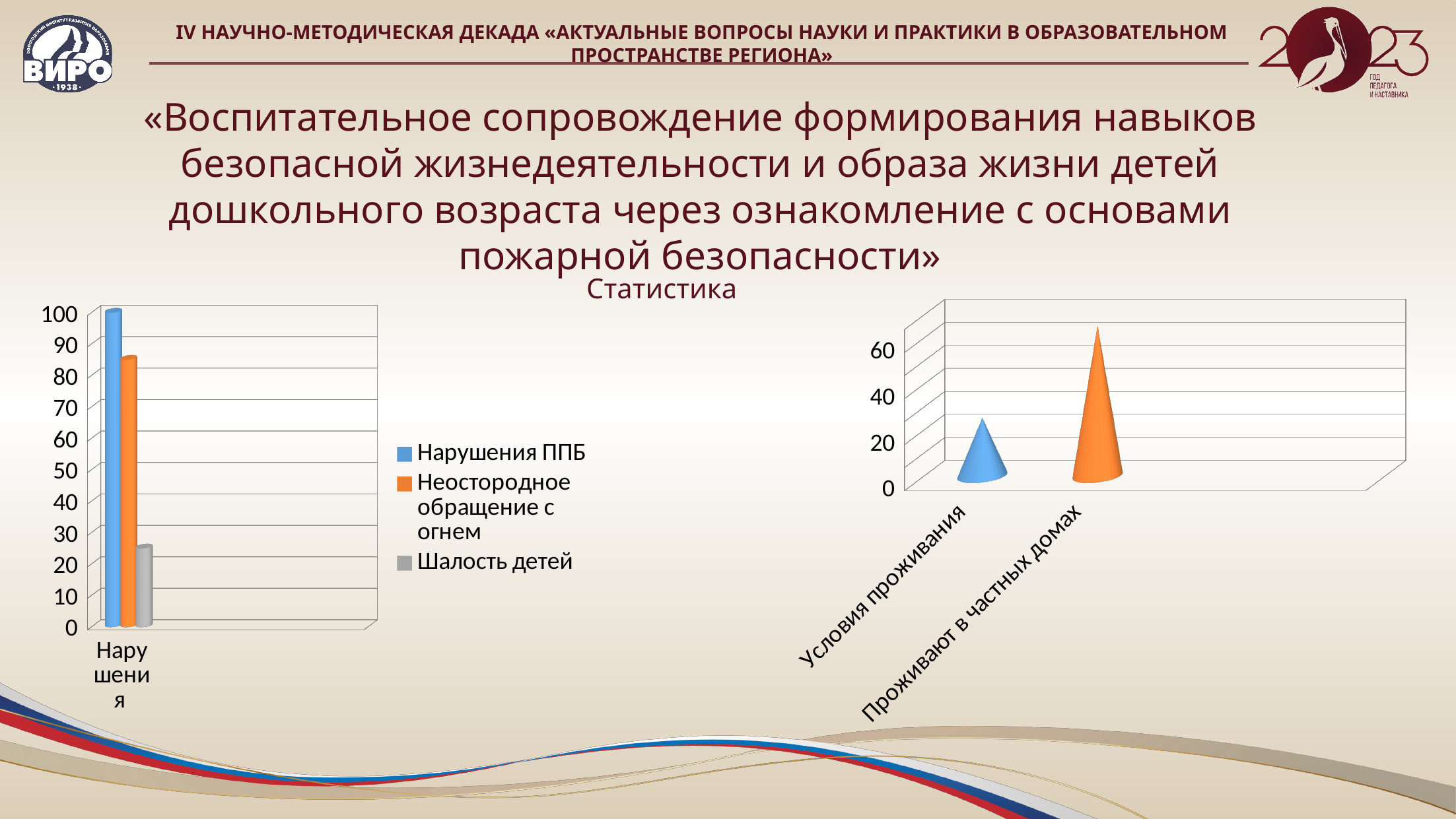
How many categories are shown on the x axis of the right chart? 2 In the left chart, which series has the highest value? Нарушения ППБ In the left chart, is the value for Шалость детей greater or less than 30? less How many series does the legend of the left chart list? 3 What kind of chart is the left chart on the slide? bar chart In the right chart, is the value for Условия проживания greater or less than 40? less In the right chart, which category has the higher value? Проживают в частных домах In the left chart, is the value for Неосторожное обращение с огнем greater or less than 80? greater In the left chart, which is larger: Неосторожное обращение с огнем or Шалость детей? Неосторожное обращение с огнем In the left chart, which series has the lowest value? Шалость детей In the left chart, what colour represents Шалость детей in the legend? gray